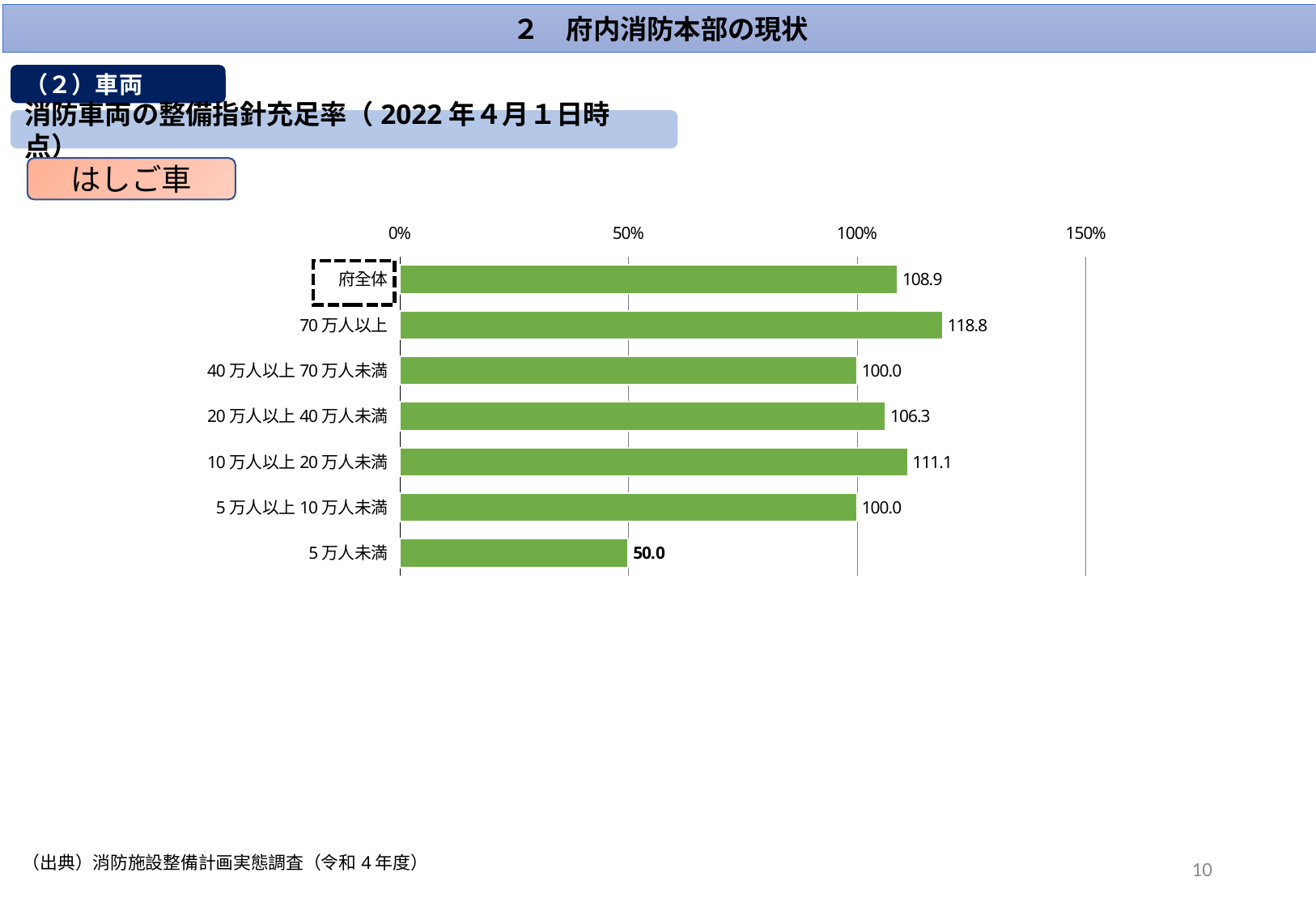
How many categories are shown in the chart? 7 What is the value for 5万人未満? 50.0 What is the value for 10万人以上20万人未満? 111.1 What is the value for 70万人以上? 118.8 Which category has the highest value? 70万人以上 Which is larger, the value for 10万人以上20万人未満 or the value for 20万人以上40万人未満? 10万人以上20万人未満 What is the value for 府全体? 108.9 What is the difference between the values for 70万人以上 and 府全体? 9.9 What kind of chart is shown on the slide? bar chart Which category has the lowest value? 5万人未満 What is the difference between the values for 20万人以上40万人未満 and 5万人未満? 56.3 What is the label in the orange box above the chart? はしご車